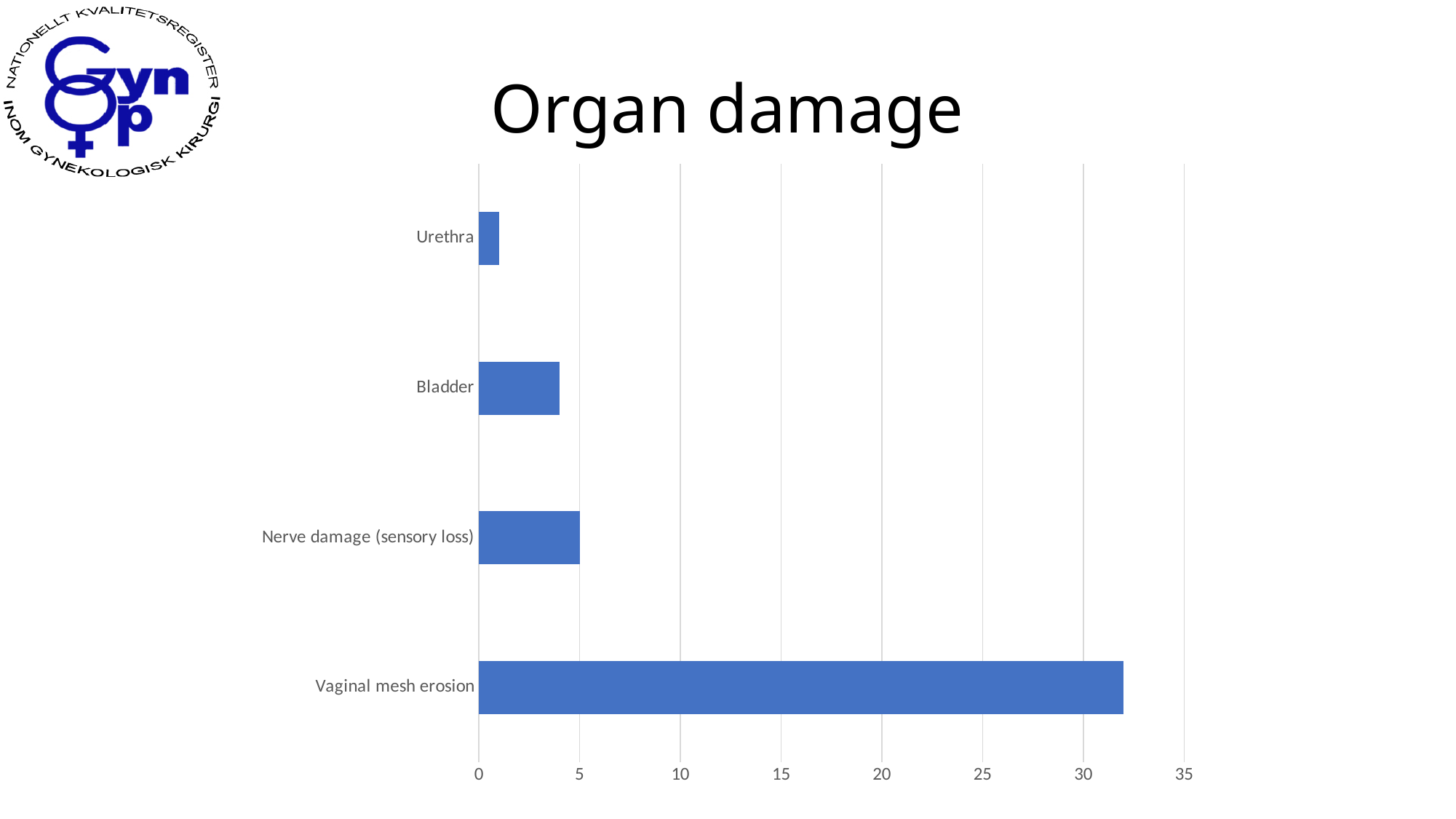
How many categories are plotted in the chart? 4 What kind of chart is shown on the slide? bar chart Which category has the highest value? Vaginal mesh erosion What is the title of the chart? Organ damage Is the value for Vaginal mesh erosion greater or less than 30? greater Which is larger, the value for Nerve damage (sensory loss) or the value for Vaginal mesh erosion? Vaginal mesh erosion Is the value for Bladder greater or less than 5? less Is the value for Urethra greater or less than 5? less What is the value for Nerve damage (sensory loss)? 5 Which category has the lowest value? Urethra What is the highest value shown on the horizontal axis? 35 Which is larger, the value for Bladder or the value for Urethra? Bladder